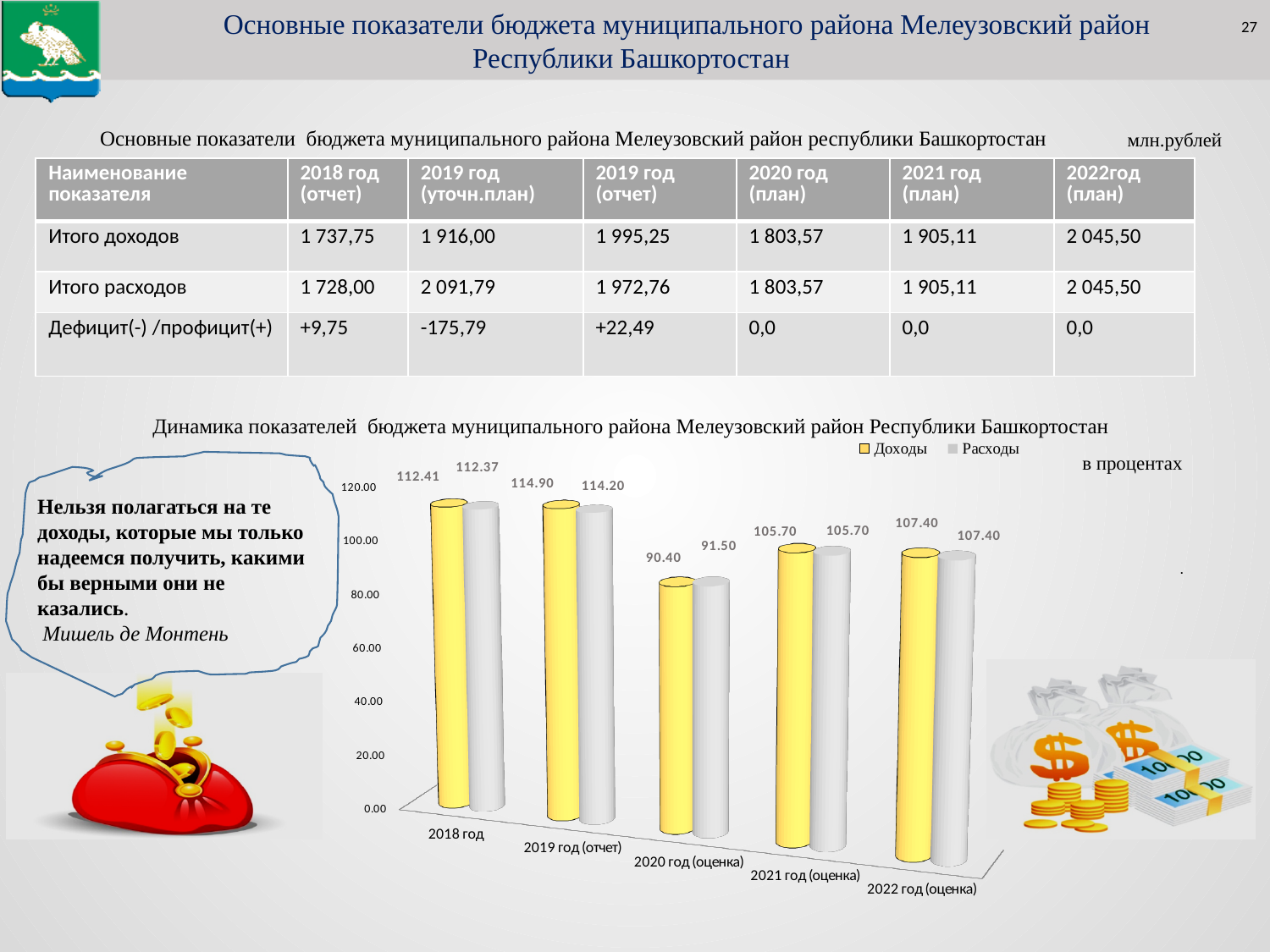
What kind of chart is shown on the slide? bar chart Which year has the highest Доходы value? 2019 год (отчет) Which series is shown in yellow on the chart? Доходы How many series does the chart legend list? 2 What is the value of Расходы for 2022 год (оценка)? 107.40 What is the value of Расходы for 2019 год (отчет)? 114.20 Is the Доходы value for 2020 год (оценка) greater or less than 100.00? less What is the value of Доходы for 2018 год? 112.41 What is the difference between Расходы and Доходы for 2020 год (оценка)? 1.10 Which year has the lowest Расходы value? 2020 год (оценка) What is the value of Доходы for 2020 год (оценка)? 90.40 How many year categories are plotted on the chart? 5